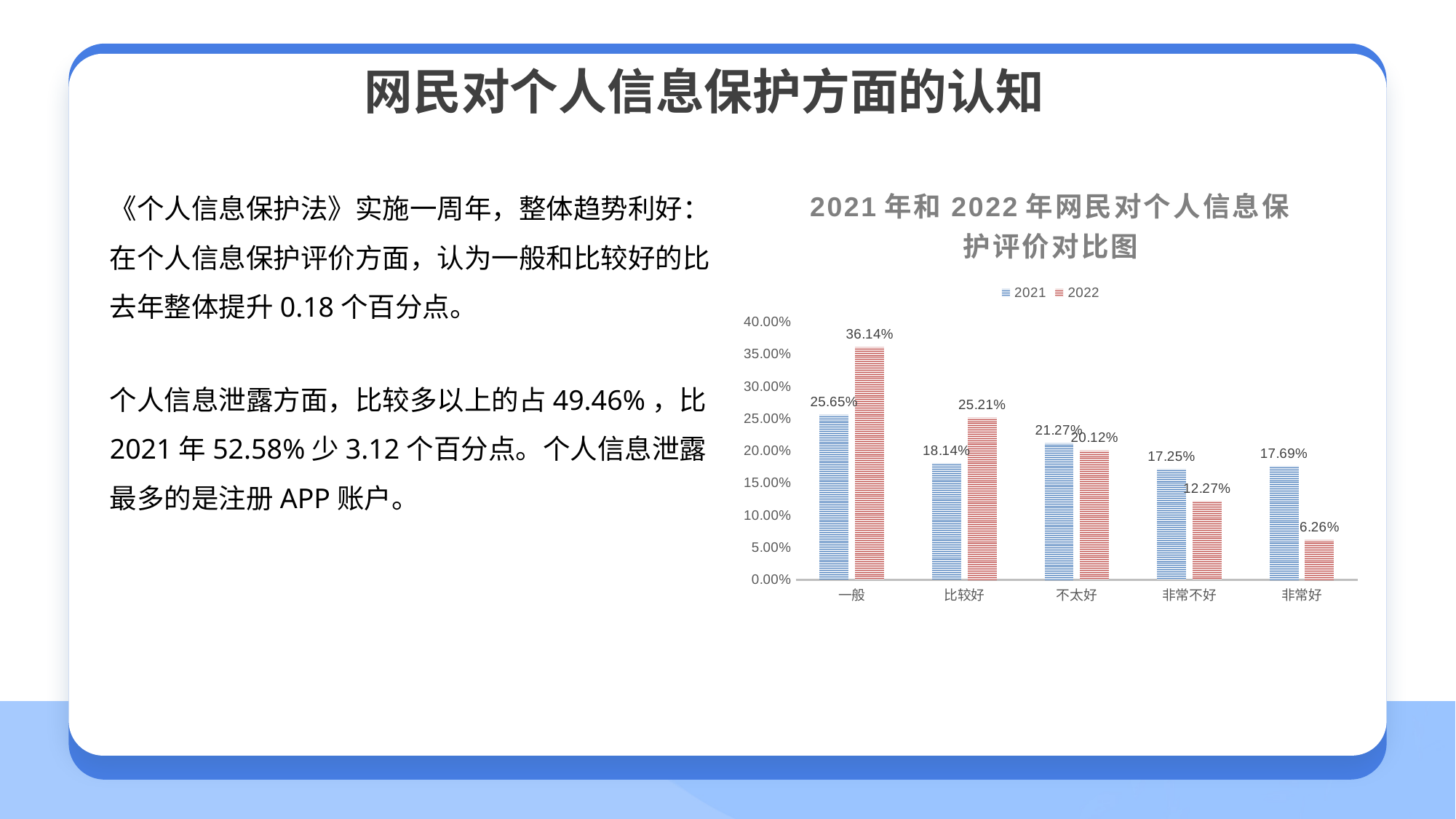
What is the 2022 value for 一般 in the chart? 36.14% How many series does the chart's legend list? 2 What is the 2022 value for 非常好 in the chart? 6.26% Which category has the highest 2022 value in the chart? 一般 What is the 2021 value for 不太好 in the chart? 21.27% What is the difference between the 2022 and 2021 values for 一般? 10.49% Which is larger for 非常不好: the 2021 value or the 2022 value? 2021 What kind of chart is shown on the slide? Bar chart How many categories are shown on the x axis of the chart? 5 Which category has the lowest 2022 value in the chart? 非常好 What is the 2021 value for 比较好 in the chart? 18.14% Which category has the lowest 2021 value in the chart? 非常不好